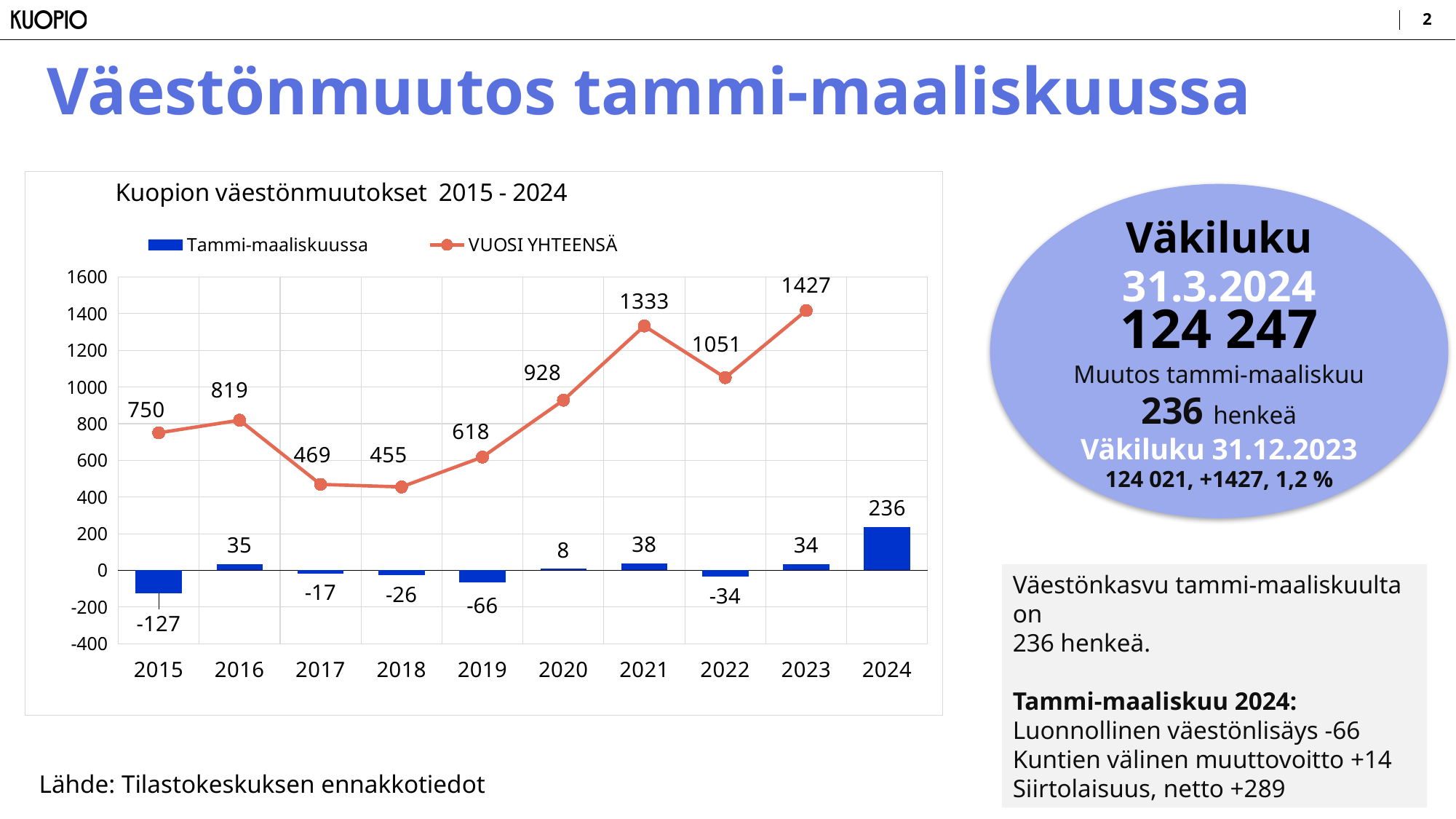
Which is larger, the VUOSI YHTEENSÄ value for 2016 or for 2019? 2016 What is the Tammi-maaliskuussa value for 2024? 236 How many years are shown on the x axis of the chart? 10 How many series does the chart legend list? 2 What is the VUOSI YHTEENSÄ value for 2021? 1333 What is the difference between the VUOSI YHTEENSÄ values for 2023 and 2022? 376 Which year has the highest VUOSI YHTEENSÄ value? 2023 What is the title of the chart? Kuopion väestönmuutokset 2015 - 2024 Which year has the lowest Tammi-maaliskuussa value? 2015 What kind of chart is used for the Tammi-maaliskuussa series? bar chart What is the Tammi-maaliskuussa value for 2015? -127 Is the VUOSI YHTEENSÄ value for 2020 greater or less than 1000? less